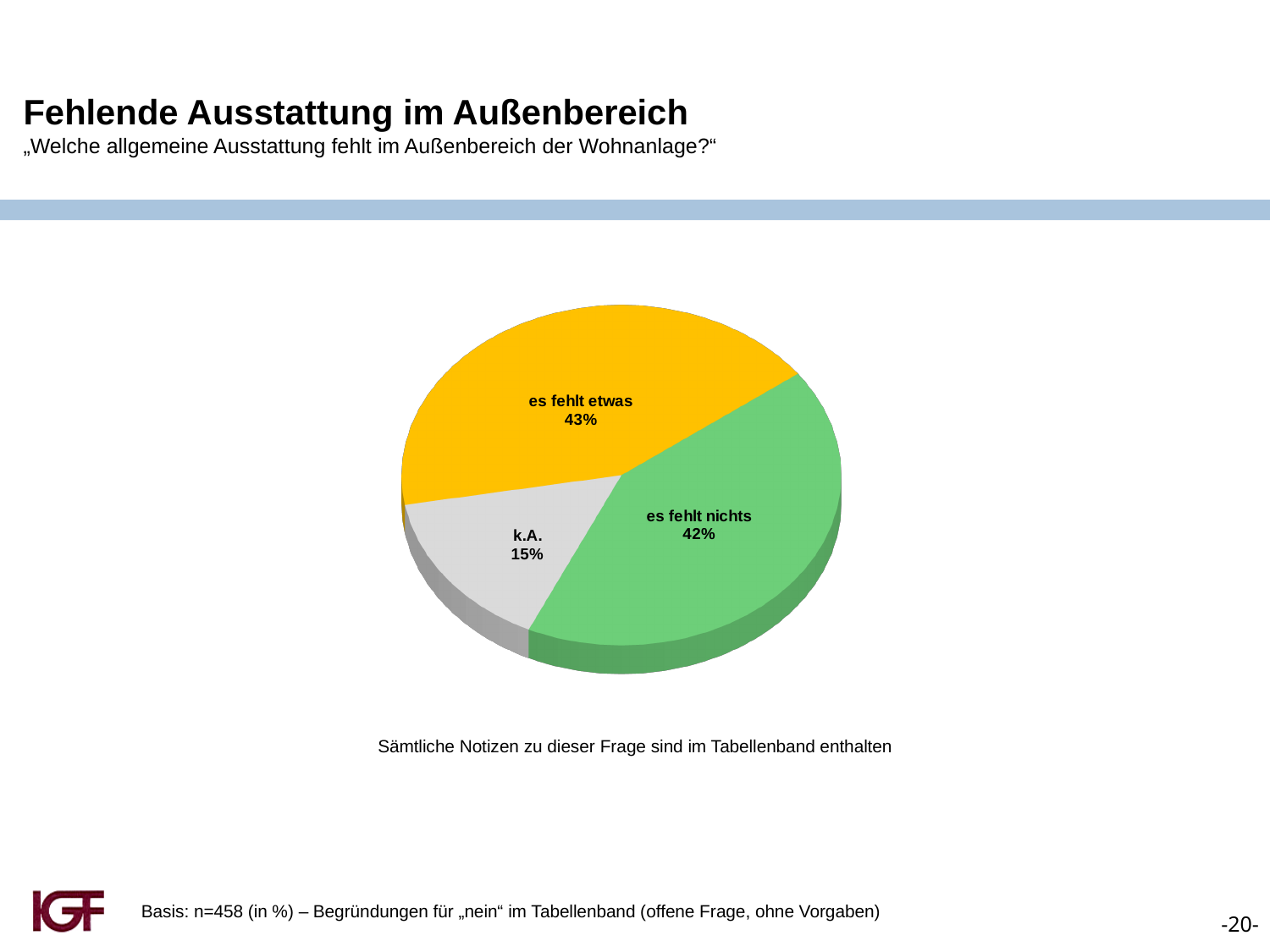
What percentage of the pie chart is labelled "es fehlt nichts"? 42% Which slice of the pie chart is the smallest? k.A. Which is larger: the share for "es fehlt nichts" or the share for "k.A."? es fehlt nichts What percentage of the pie chart is labelled "es fehlt etwas"? 43% Which slice of the pie chart is the largest according to the printed labels? es fehlt etwas How many slices does the pie chart have? 3 What colour is the "es fehlt nichts" slice of the pie chart? green What is the difference in percentage points between "es fehlt etwas" and "k.A."? 28 What is the sample size (n) stated at the bottom of the slide? n=458 What is the difference in percentage points between "es fehlt etwas" and "es fehlt nichts"? 1 What percentage of the pie chart is labelled "k.A."? 15% What type of chart is shown on the slide? pie chart